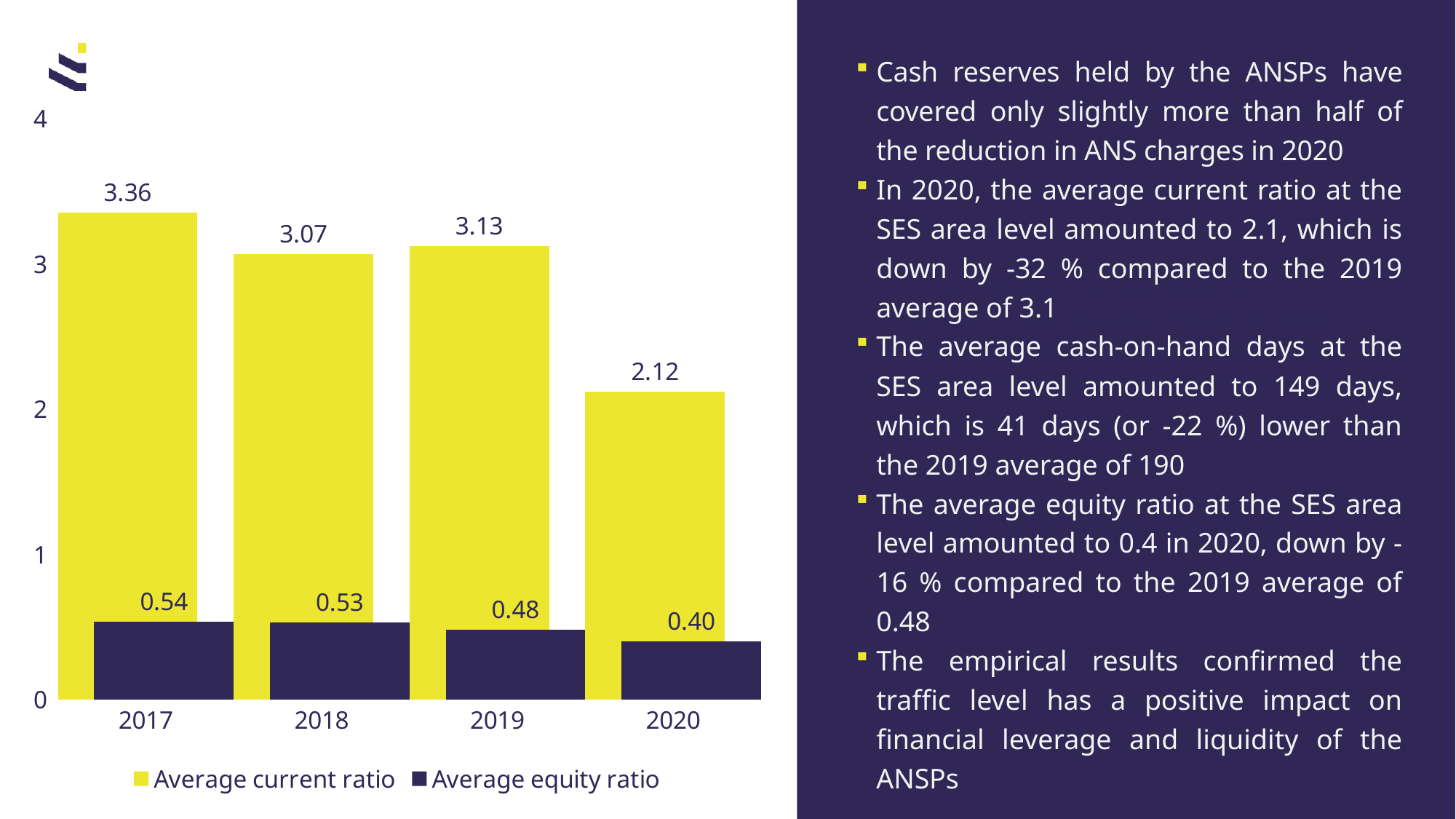
How many years are shown on the x axis? 4 What is the difference between the average current ratio in 2019 and in 2020? 1.01 What is the average current ratio in 2017? 3.36 Which colour represents the average equity ratio in the chart? dark navy Which year has the highest average current ratio? 2017 What kind of chart is shown on the slide? bar chart Is the average current ratio in 2020 greater or less than 3? less Which year has the lowest average equity ratio? 2020 What is the average current ratio in 2019? 3.13 What is the average equity ratio in 2020? 0.40 How many series does the legend list? 2 Which is larger, the average current ratio in 2018 or in 2019? 2019